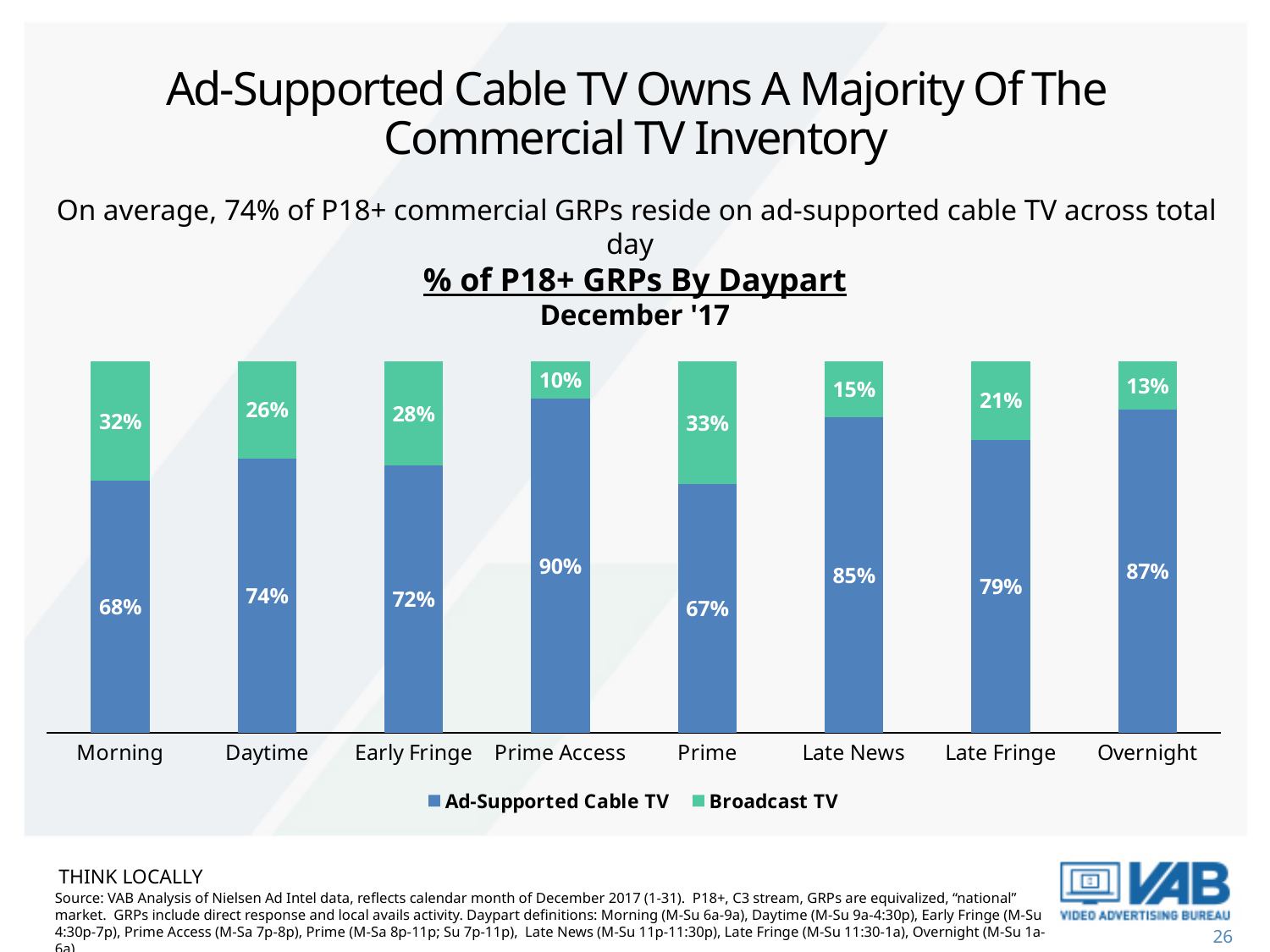
Which daypart has the highest Ad-Supported Cable TV share? Prime Access How many dayparts are shown on the x axis? 8 Which is larger, the Broadcast TV value for Late News or for Late Fringe? Late Fringe What is the Broadcast TV value for Morning? 32% Which daypart has the highest Broadcast TV share? Prime What kind of chart is shown? Stacked bar chart What is the Ad-Supported Cable TV value for Late Fringe? 79% How many series does the legend list? 2 What is the difference between the Ad-Supported Cable TV values for Overnight and Daytime? 13% Which daypart has the lowest Ad-Supported Cable TV share? Prime What is the total of the stacked bar for Early Fringe? 100% What is the Ad-Supported Cable TV value for Prime Access? 90%